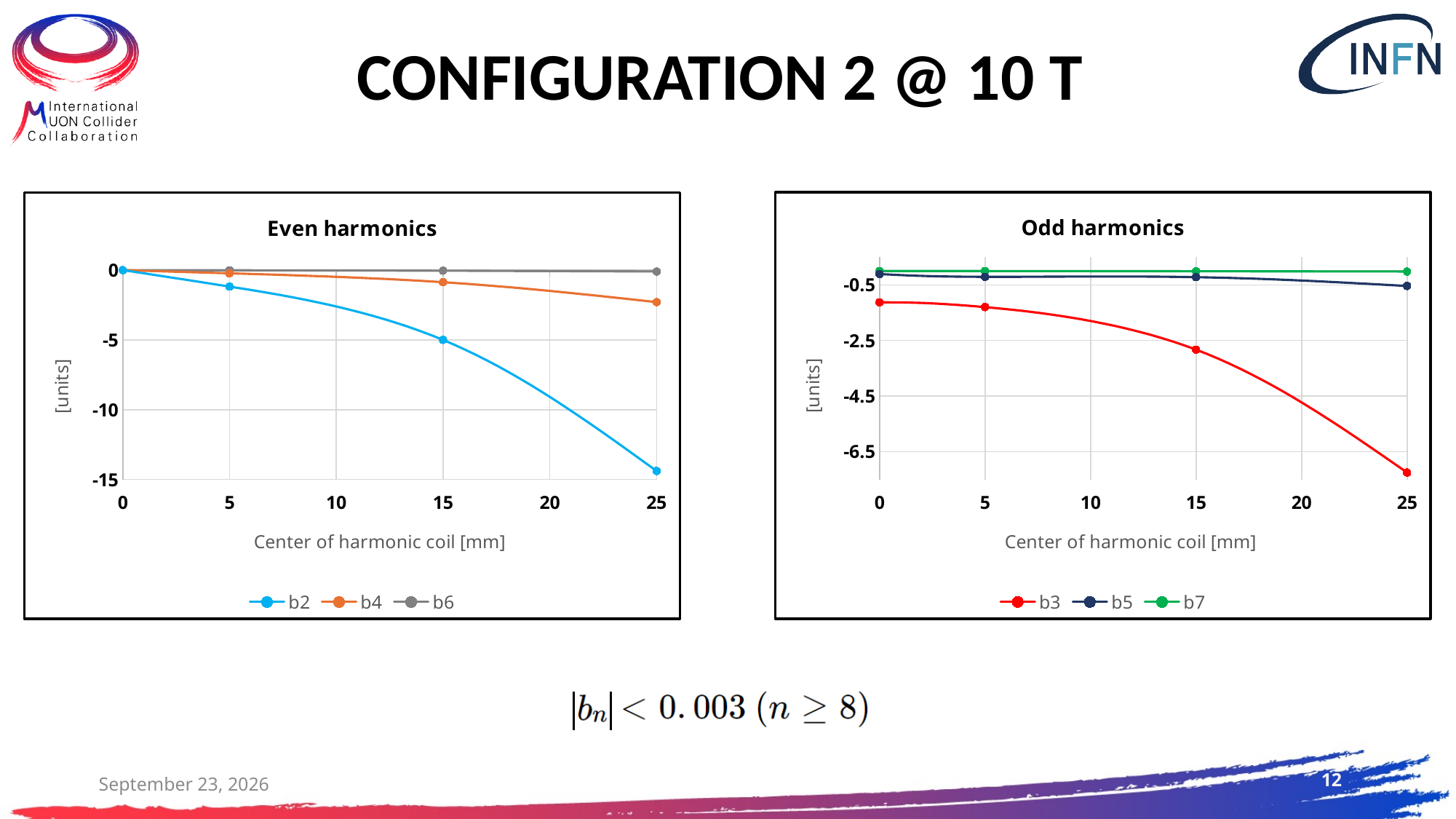
In the Even harmonics chart, is the value of b4 at 25 mm greater or less than -5? greater In the Odd harmonics chart, which series has the lowest value at 25 mm? b3 In the Odd harmonics chart, is the value of b3 at 0 mm greater or less than -2.5? greater In the Even harmonics chart, which is larger at 25 mm, b2 or b4? b4 In the Even harmonics chart, does the b2 series rise or fall as the center of the harmonic coil increases? fall What kind of chart is the Even harmonics chart? line chart How many series does the legend of the Odd harmonics chart list? 3 In the Odd harmonics chart, is the value of b3 at 25 mm greater or less than -6.5? less In the Even harmonics chart, what is the value of b2 at a harmonic coil center of 0 mm? 0 In the Even harmonics chart, which series has the lowest value at 25 mm? b2 In the Even harmonics chart, how many data points are plotted for the b2 series? 4